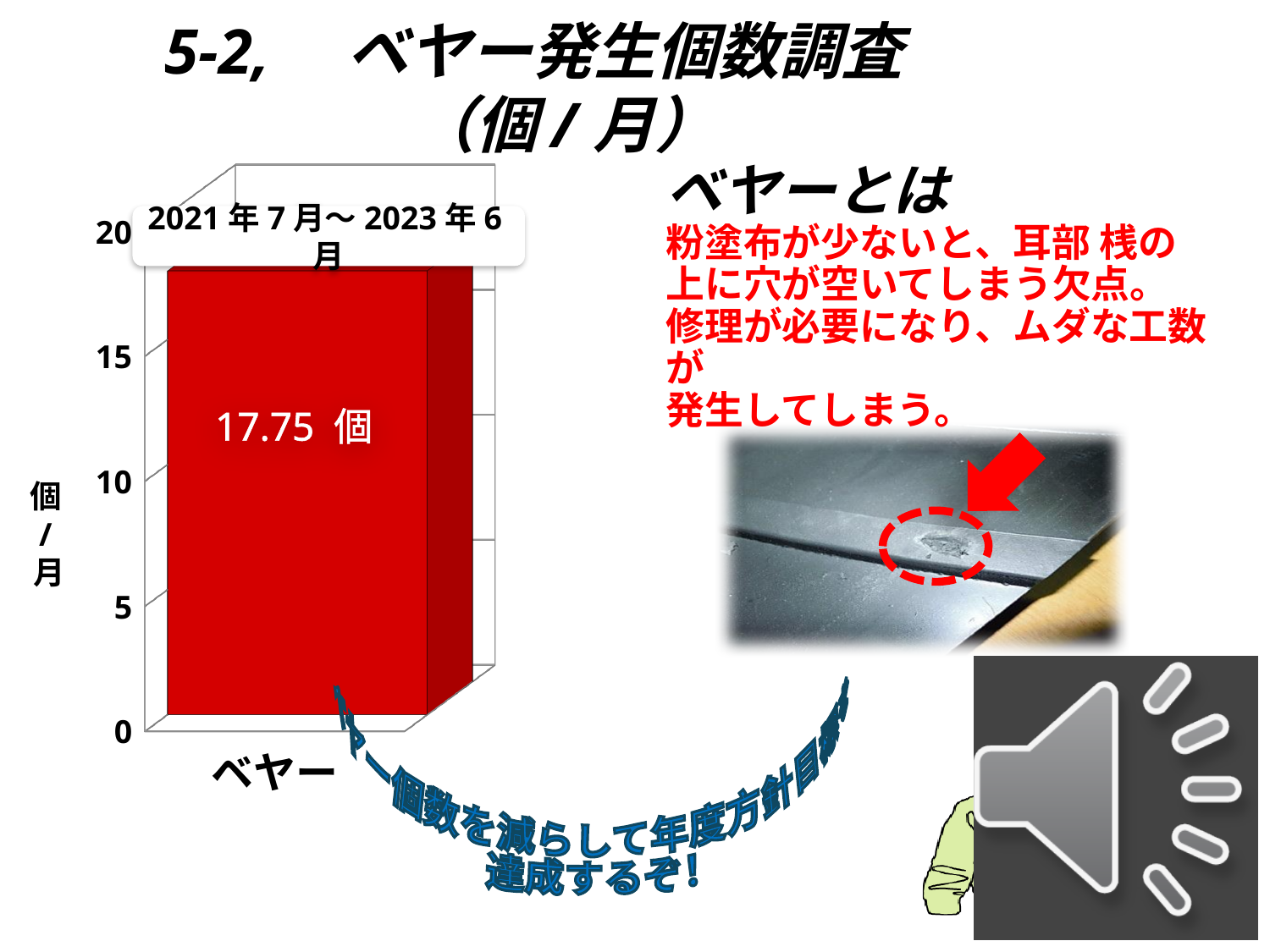
What unit is given on the chart's vertical axis label? 個/月 What kind of chart is shown on the slide? bar chart Is the value for ベヤー greater or less than 20? less What is the value shown for ベヤー in the chart? 17.75 個 Is the value for ベヤー greater or less than 15? greater How many bars (categories) does the chart show? 1 What is the maximum value shown on the chart's vertical axis? 20 What period does the text box on the chart say the data covers? 2021年7月～2023年6月 What is the label of the category on the x axis of the chart? ベヤー